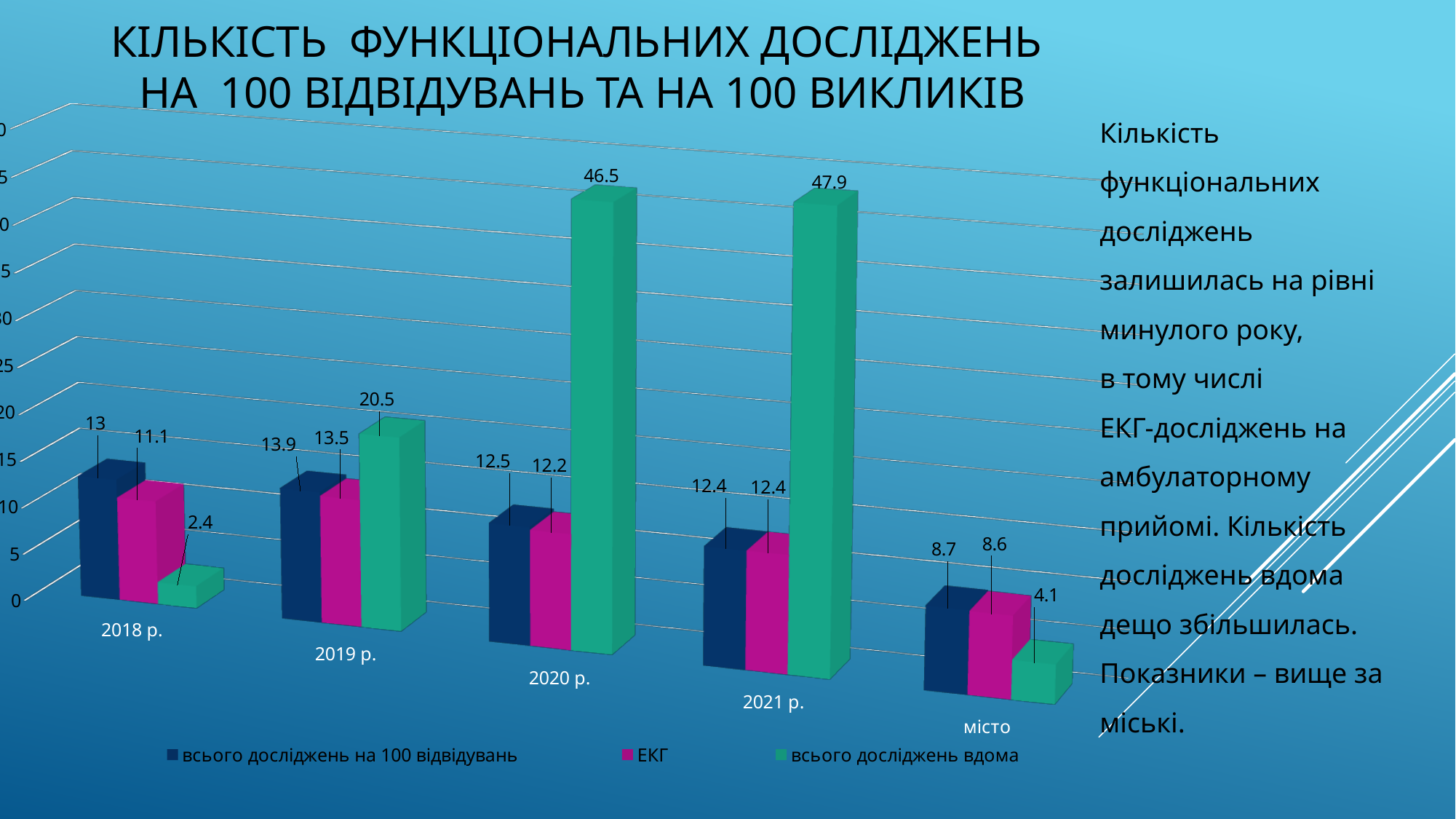
Which colour represents the 'ЕКГ' series in the legend? Magenta Which is larger: the 'ЕКГ' value for 2019 р. or for 2020 р.? 2019 р. What is the difference between the 'всього досліджень вдома' values for 2021 р. and 2020 р.? 1.4 Which category has the lowest value for 'всього досліджень вдома'? 2018 р. What is the value of 'ЕКГ' for 2018 р.? 11.1 How many series does the legend list? 3 What kind of chart is shown on the slide? Bar chart How many categories are shown on the x axis? 5 Does the 'всього досліджень на 100 відвідувань' series rise or fall from 2019 р. to 2021 р.? Fall What is the value of 'всього досліджень вдома' for 2020 р.? 46.5 Which category has the highest value for 'всього досліджень вдома'? 2021 р. What is the value of 'всього досліджень на 100 відвідувань' for місто? 8.7